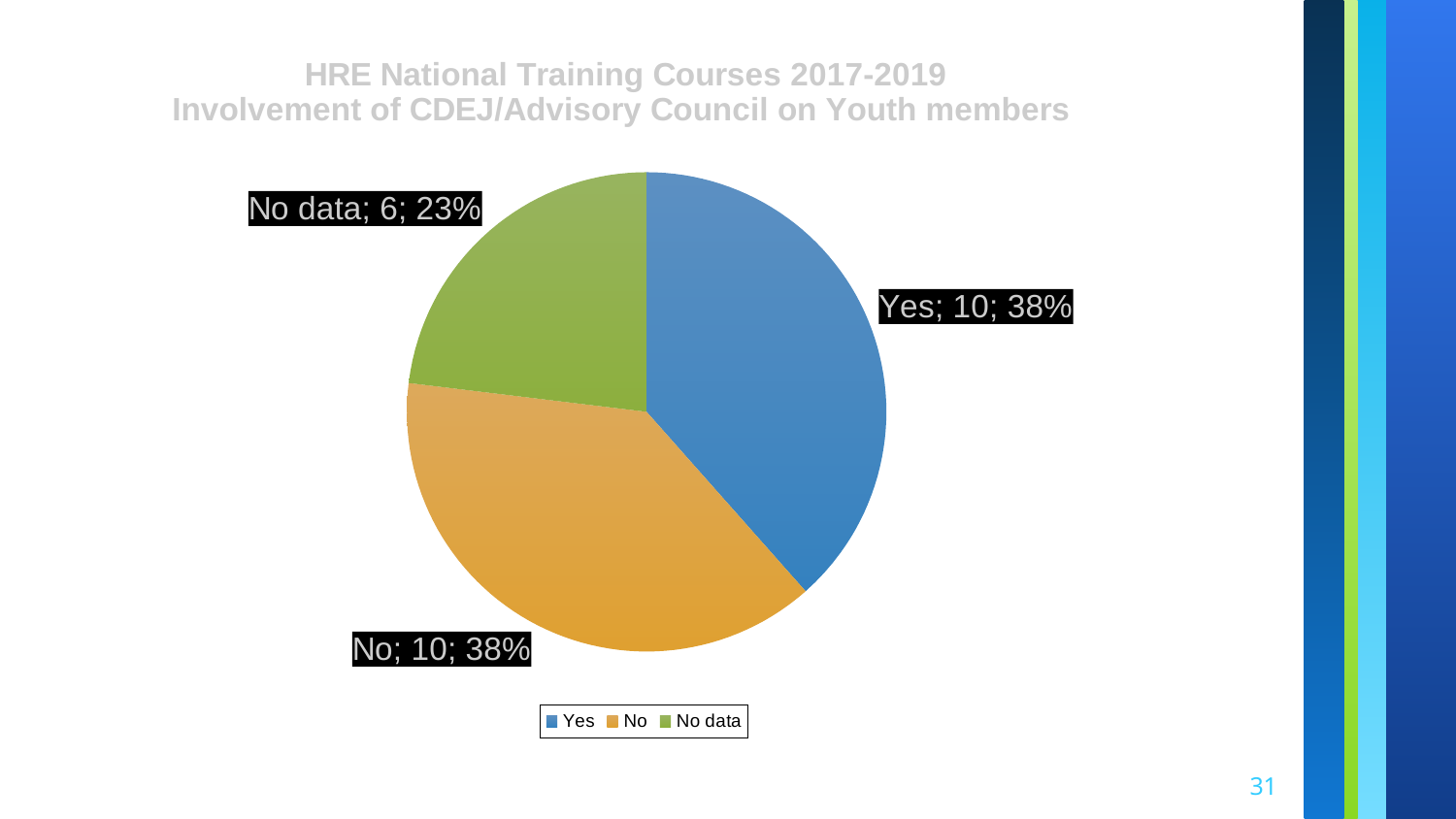
What percentage share does the 'No' slice have? 38% What colour is the 'No' slice? orange What is the total of all the slice values? 26 Which is larger, the 'No' slice or the 'No data' slice? No What is the value for the 'Yes' slice? 10 What kind of chart is shown on the slide? pie chart Which category has the smallest slice? No data What is the difference between the 'Yes' value and the 'No data' value? 4 What is the value for the 'No data' slice? 6 What percentage share does the 'No data' slice have? 23% What is the title of the chart? HRE National Training Courses 2017-2019 Involvement of CDEJ/Advisory Council on Youth members How many categories does the pie chart have? 3